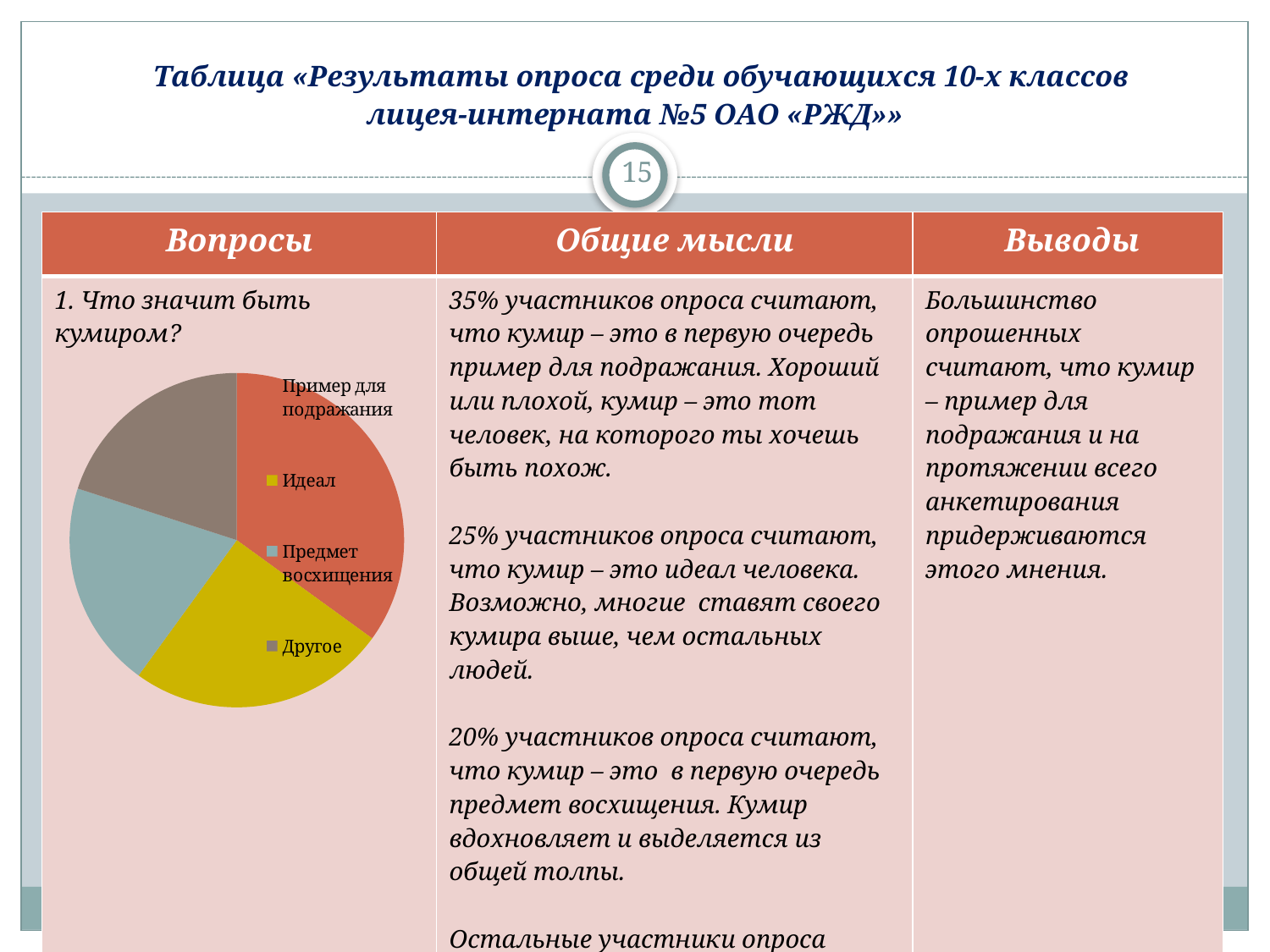
Which slice is larger in the pie chart: Пример для подражания or Другое? Пример для подражания On which side of the pie chart is the legend placed? right Which slice is larger in the pie chart: Идеал or Предмет восхищения? Идеал Which category has the largest slice in the pie chart? Пример для подражания Which slice is larger in the pie chart: Пример для подражания or Идеал? Пример для подражания What kind of chart is shown on the slide? pie chart How many entries does the legend of the pie chart list? 4 How many slices does the pie chart have? 4 What colour is the Идеал slice in the pie chart? yellow